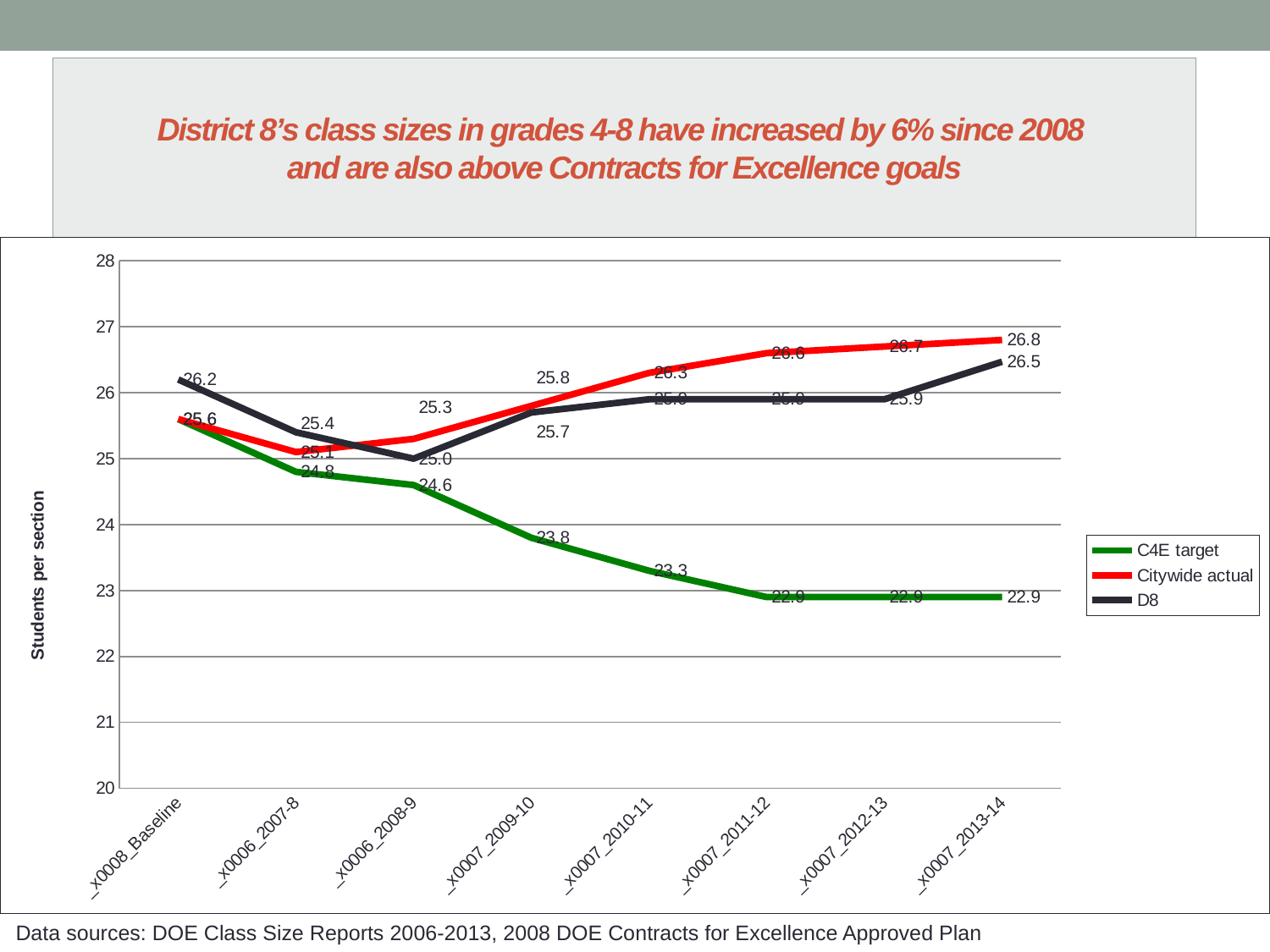
What is the difference between the Citywide actual and D8 values in 2013-14? 0.3 What is the D8 value at the Baseline point? 26.2 What kind of chart is shown on the slide? line chart Which is larger in 2010-11, the Citywide actual value or the D8 value? Citywide actual What is the D8 value for 2008-9? 25.0 Which series has the lowest value in 2013-14? C4E target What is the difference between the D8 value and the C4E target value in 2011-12? 3.0 Does the C4E target series rise or fall from Baseline to 2013-14? fall What is the Citywide actual value for 2013-14? 26.8 What is the label on the vertical axis? Students per section What is the C4E target value for 2009-10? 23.8 How many series does the legend list? 3